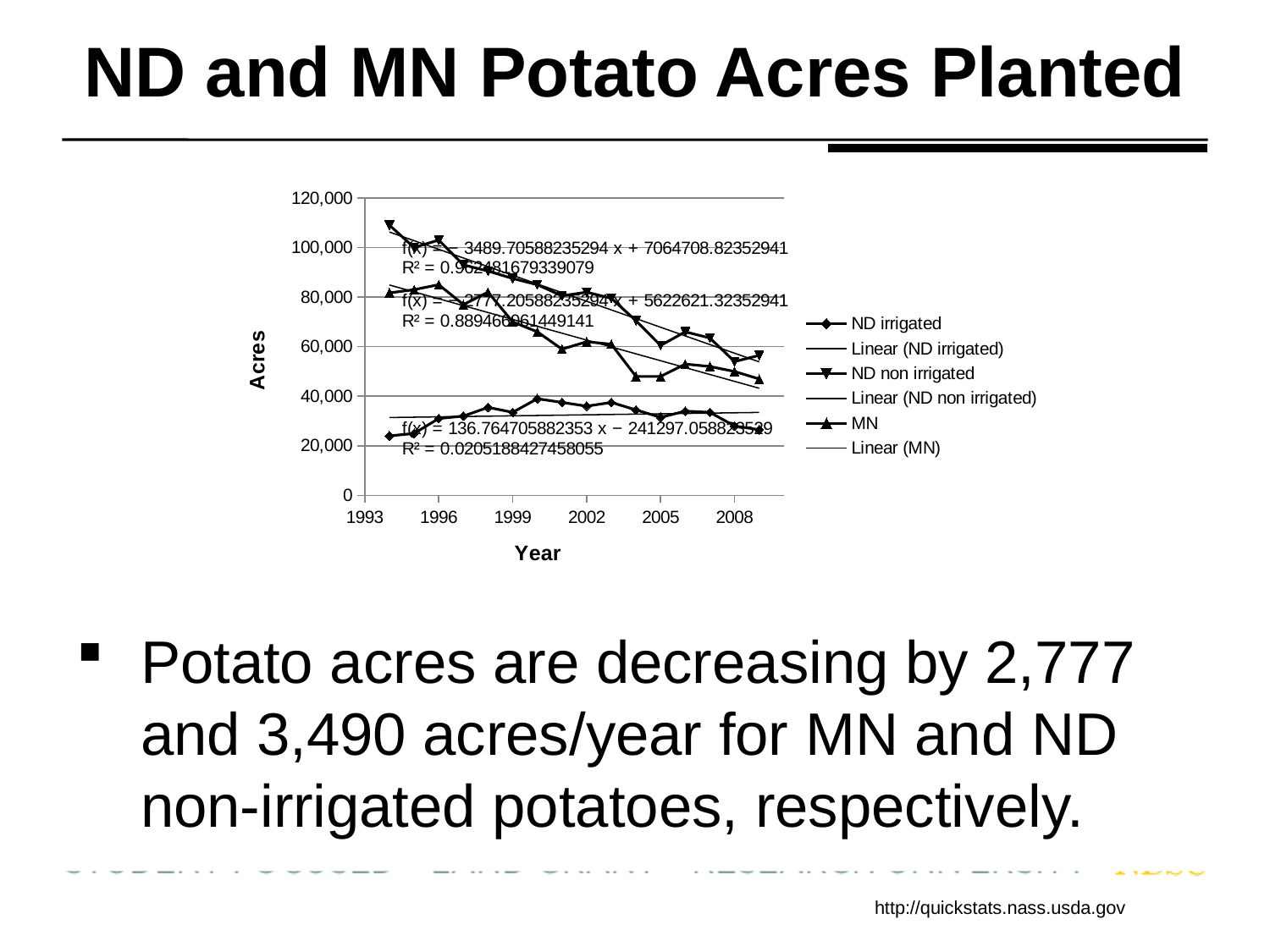
Is the ND non irrigated value in 1994 greater or less than 100,000? greater What is the title of the chart on the slide? ND and MN Potato Acres Planted How many entries does the chart legend list? 6 What is the label of the vertical axis? Acres Is the ND irrigated value in 1994 greater or less than 40,000? less What R² value is shown for the Linear (ND irrigated) trendline? 0.0205188427458055 Do the ND non irrigated acres rise or fall from 1994 to 2009? fall Which series has the highest value in 1994? ND non irrigated In 2005, which is larger: ND non irrigated or MN? ND non irrigated What kind of chart is shown on the slide? line chart Which series has the lowest value in 1994? ND irrigated Do the MN acres rise or fall over the years shown? fall